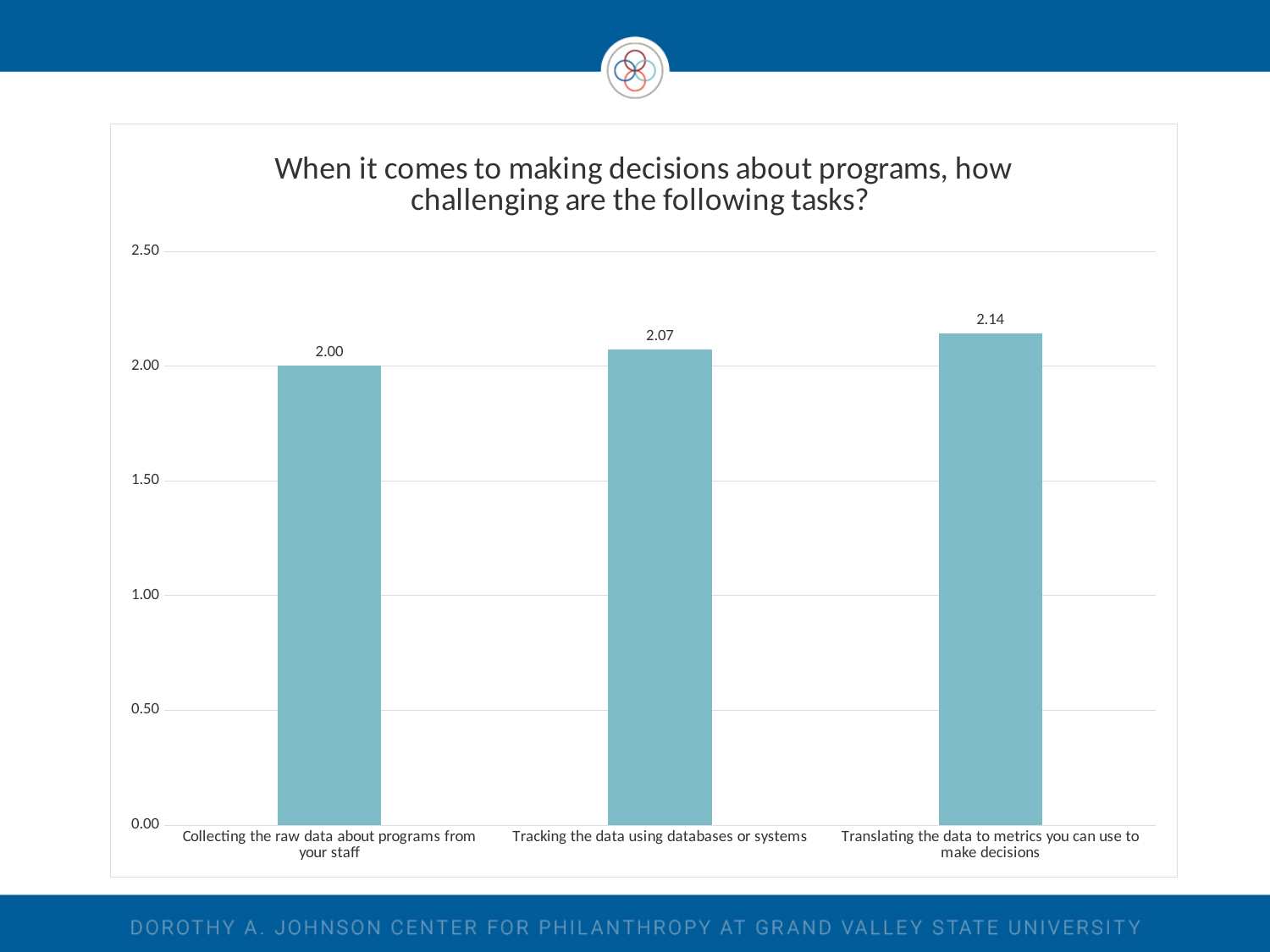
How many tasks are shown in the chart? 3 What is the value for "Translating the data to metrics you can use to make decisions"? 2.14 What kind of chart is shown on the slide? Bar chart Is the value for "Translating the data to metrics you can use to make decisions" greater or less than 2.00? greater Which is larger: the value for "Tracking the data using databases or systems" or the value for "Translating the data to metrics you can use to make decisions"? Translating the data to metrics you can use to make decisions Which task has the lowest value? Collecting the raw data about programs from your staff What is the difference between the values for "Tracking the data using databases or systems" and "Collecting the raw data about programs from your staff"? 0.07 What is the value for "Collecting the raw data about programs from your staff"? 2.00 What is the difference between the values for "Translating the data to metrics you can use to make decisions" and "Collecting the raw data about programs from your staff"? 0.14 Which task has the highest value? Translating the data to metrics you can use to make decisions What is the value for "Tracking the data using databases or systems"? 2.07 Do the values rise or fall from left to right across the tasks? Rise